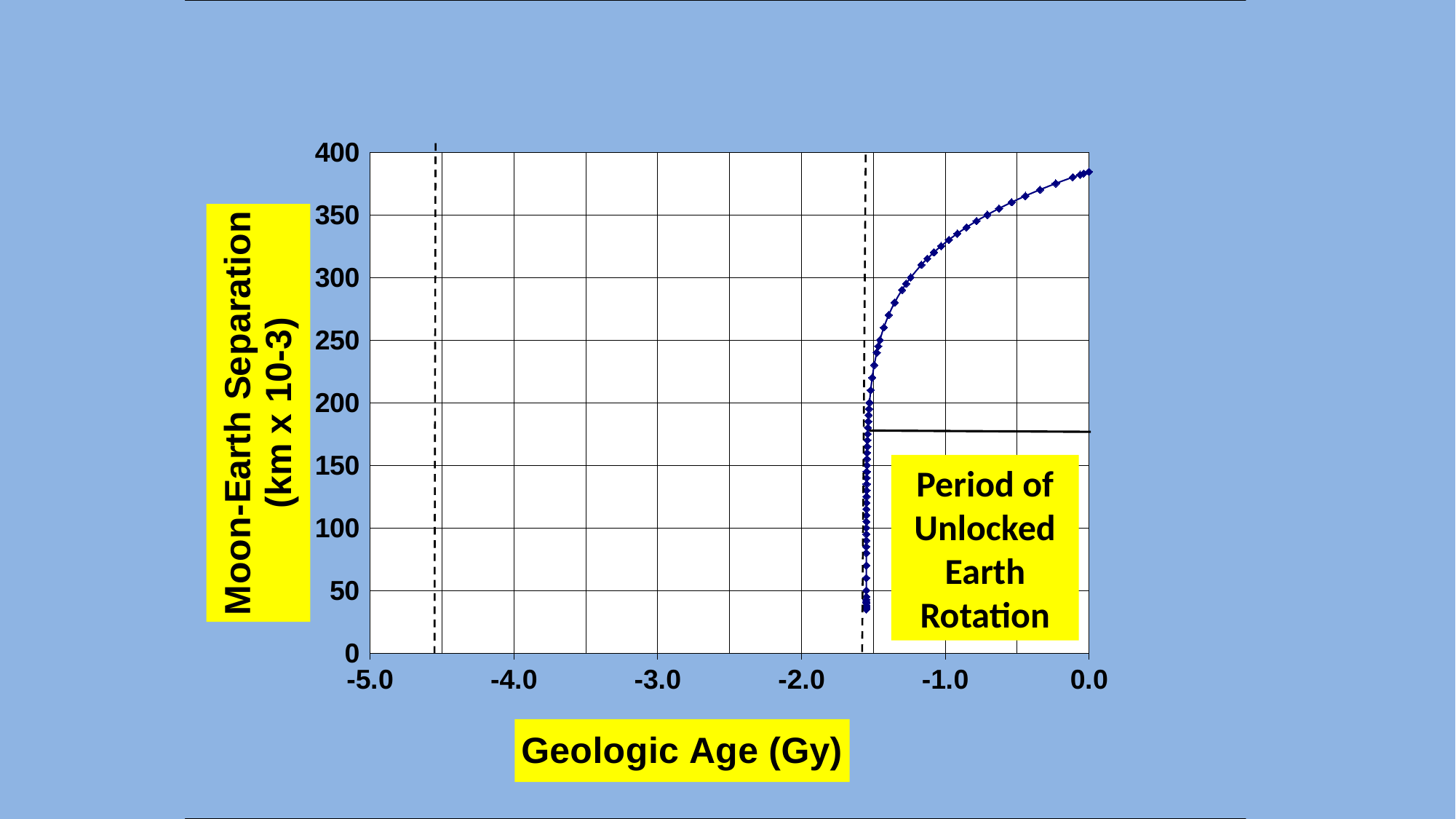
What is the maximum value shown on the y axis? 400 What is the minimum value shown on the x axis? -5.0 Does the Moon-Earth separation rise or fall as geologic age moves from -1.5 Gy toward 0.0 Gy? rise What kind of chart is shown on the slide? line chart Is the Moon-Earth separation at geologic age -1.0 Gy greater or less than 350? less Is the Moon-Earth separation at geologic age -0.5 Gy greater or less than 350? greater Is the Moon-Earth separation at geologic age -1.0 Gy greater or less than 300? greater At which geologic age on the x axis does the Moon-Earth separation reach its highest value? 0.0 Gy What is the label of the y axis? Moon-Earth Separation (km x 10-3) Which geologic age has the larger Moon-Earth separation, -1.0 Gy or -0.5 Gy? -0.5 Gy